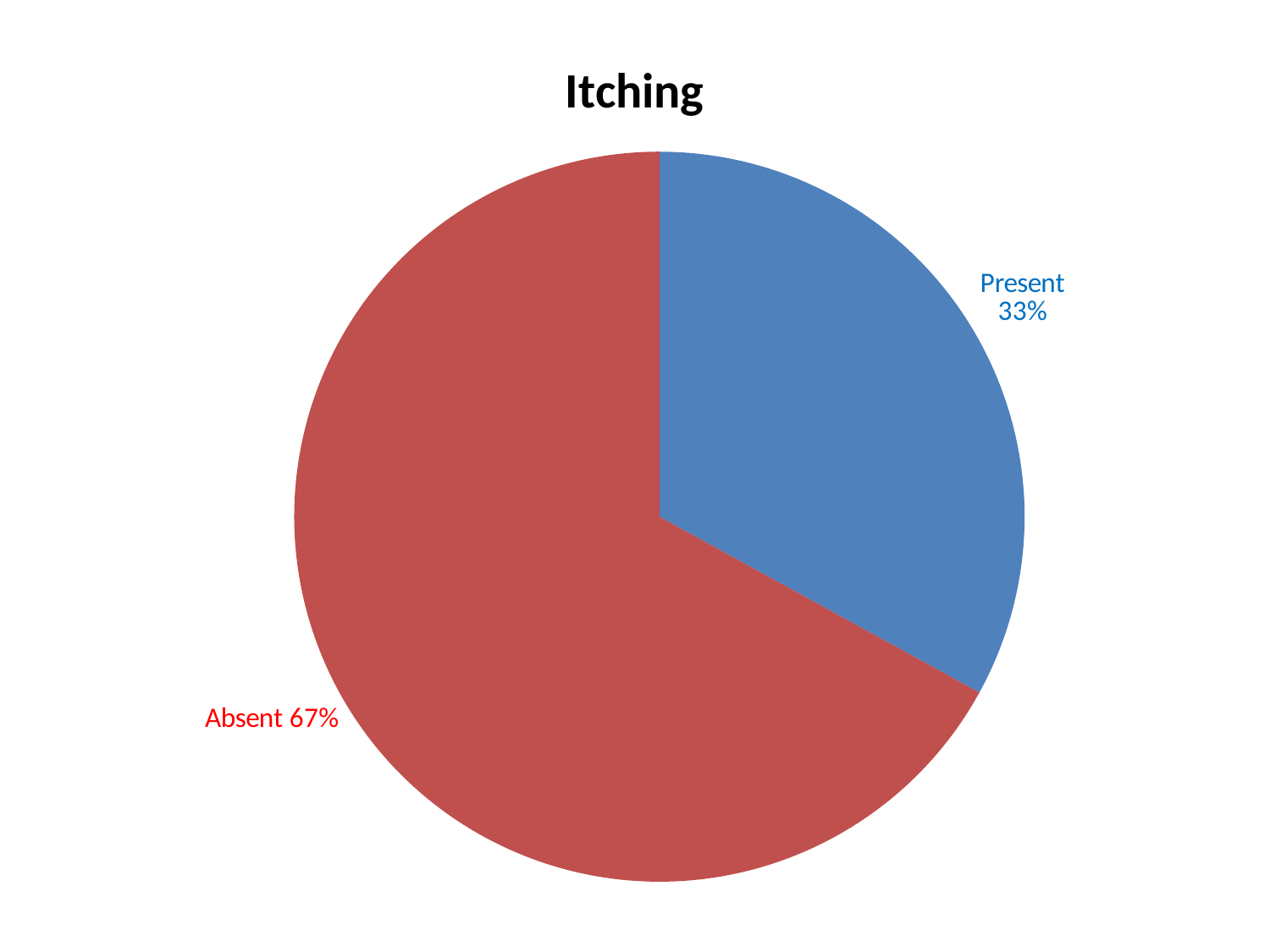
What colour is the Absent slice? red What is the title of the chart? Itching What percentage of the pie is labelled Present? 33% What percentage of the pie is labelled Absent? 67% What kind of chart is shown on the slide? pie chart What share of the pie does the Present slice represent? 33% What is the difference in percentage points between the Absent and Present slices? 34 Which slice is the largest? Absent Which is larger, the Present slice or the Absent slice? Absent Which slice is the smallest? Present How many slices does the pie chart have? 2